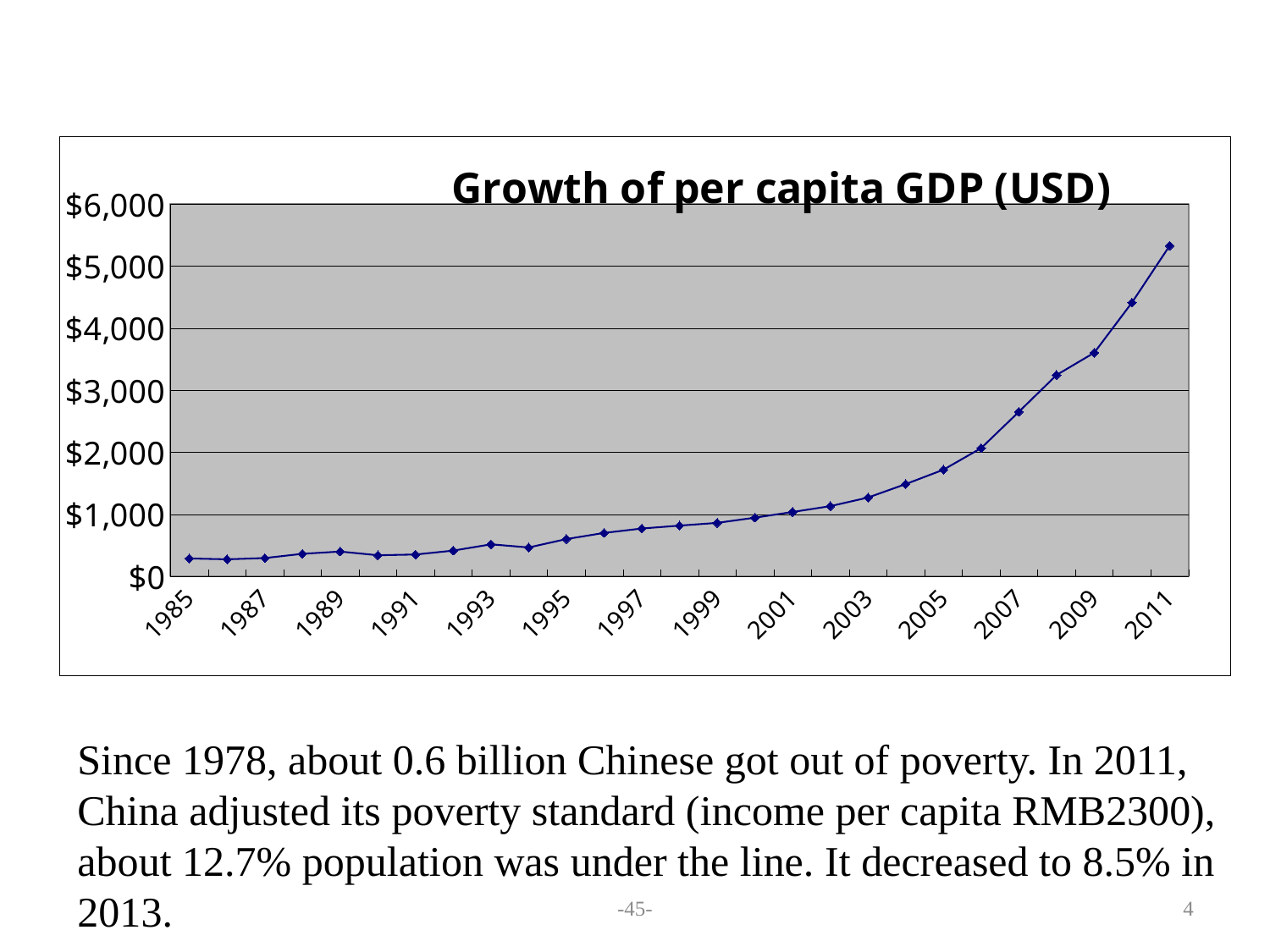
Which year has the larger per capita GDP, 2007 or 2009? 2009 Is the value for 2011 greater or less than $5,000? greater What kind of chart is shown on the slide? line chart Which year has the highest per capita GDP in the chart? 2011 Do the values generally rise or fall from 1985 to 2011? rise How many data points are plotted on the line? 27 Is the value for 1999 greater or less than $1,000? less What is the title of the chart? Growth of per capita GDP (USD) Is the value for 2010 greater or less than $4,000? greater